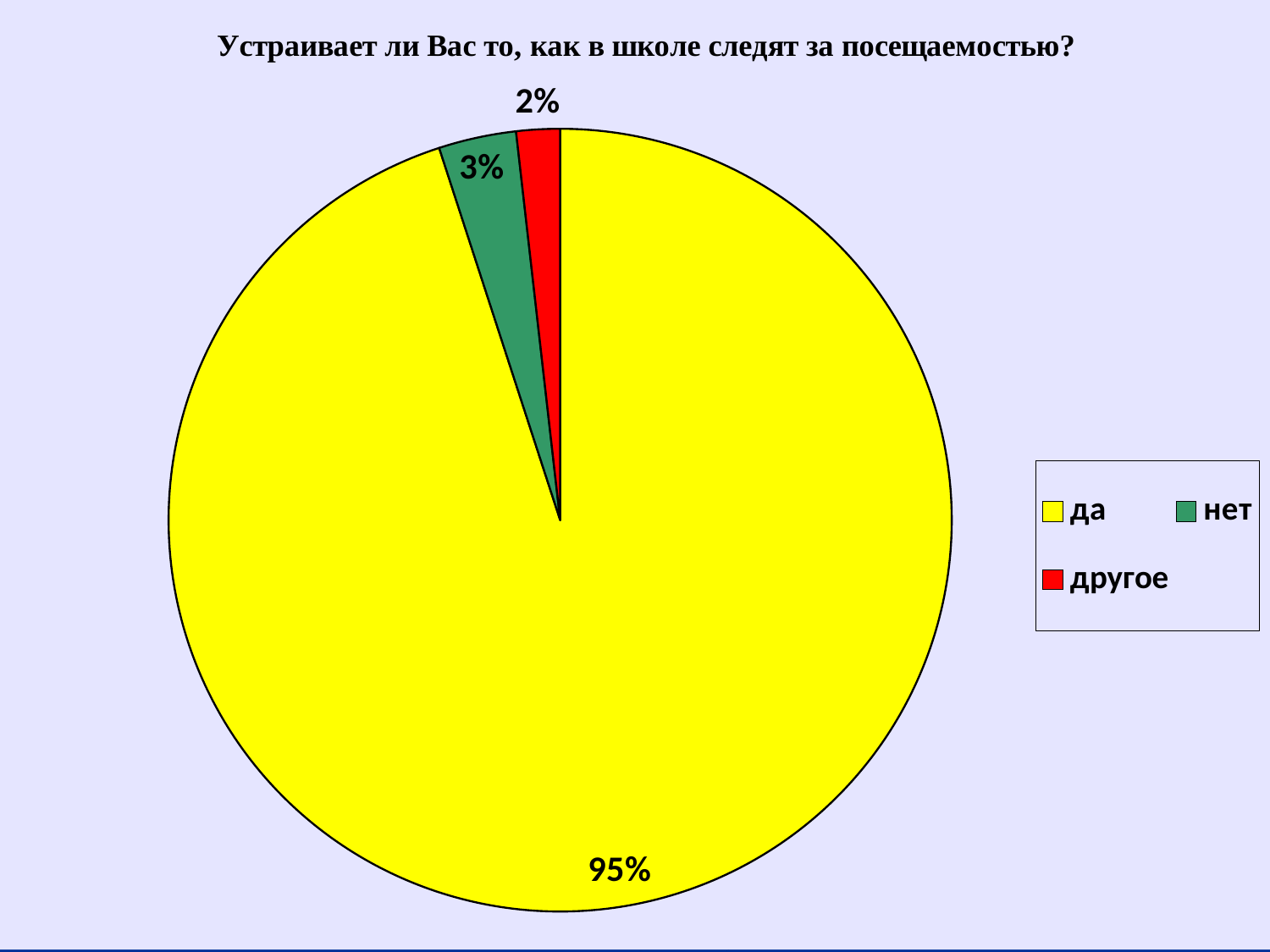
Which is larger, the slice for "нет" or the slice for "другое"? нет What colour is the slice for "другое"? red Which category has the smallest slice of the pie? другое How many entries does the legend list? 3 How many slices does the pie chart have? 3 Which category has the largest slice of the pie? да What is the difference in percentage points between "да" and "нет"? 92 What share of the pie does "другое" take? 2% What share of the pie does "да" take? 95% What is the title of the chart? Устраивает ли Вас то, как в школе следят за посещаемостью? What share of the pie does "нет" take? 3% What kind of chart is shown on the slide? pie chart